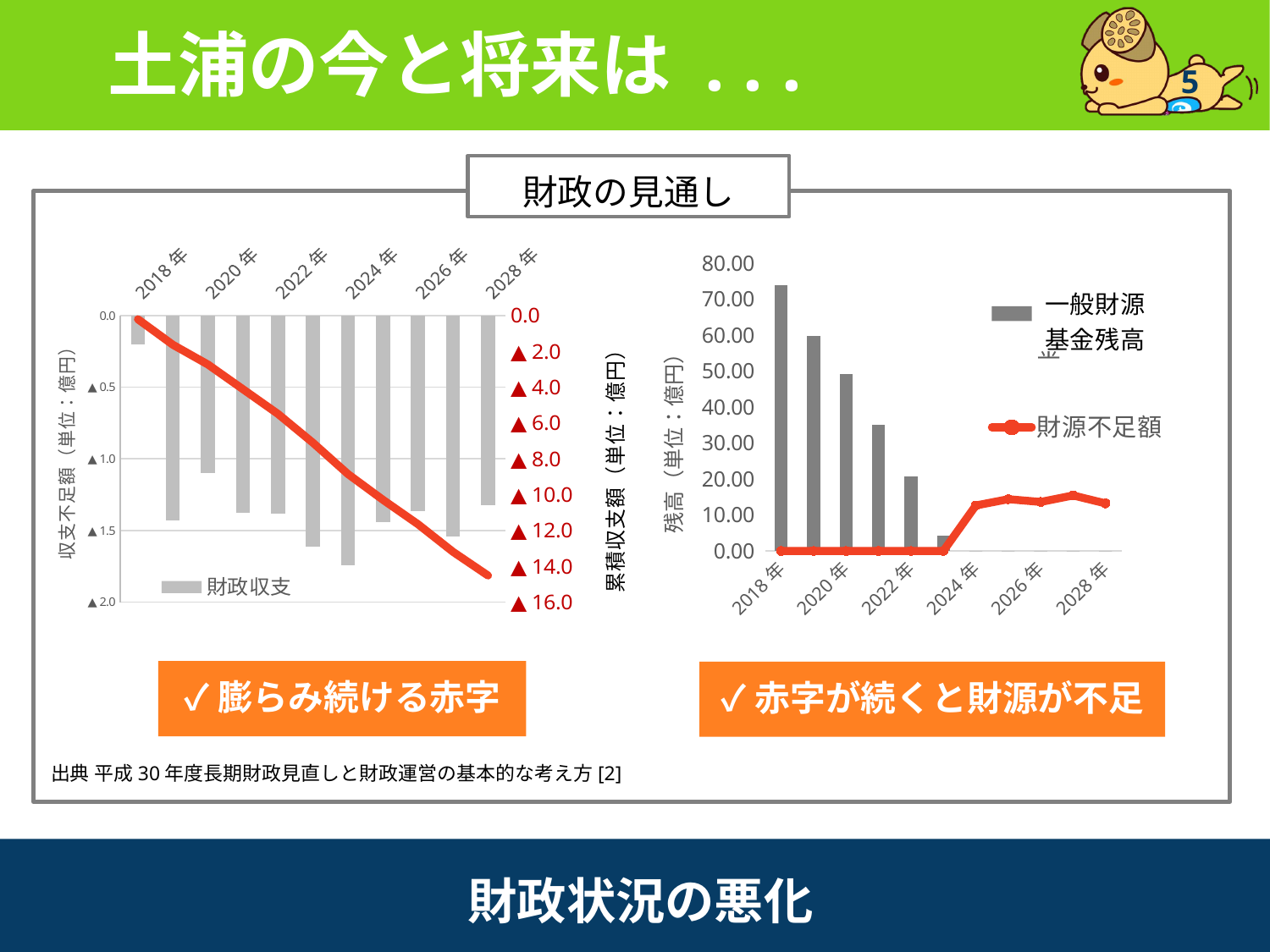
How many series does the legend of the right-hand chart list? 2 How many bars are plotted in the left-hand chart (財政収支)? 11 In the right-hand chart, do the 一般財源基金残高 bars rise or fall from 2018年 to 2023年? fall What kind of chart is the right-hand chart (残高)? Combined bar and line chart In the right-hand chart, which year has the highest 一般財源基金残高 bar? 2018年 In the right-hand chart, is the 一般財源基金残高 bar for 2018年 greater or less than 70.00? greater In the left-hand chart, does the red cumulative line rise or fall from 2018年 to 2028年? fall In the right-hand chart, which is larger: the 一般財源基金残高 bar for 2018年 or for 2022年? 2018年 In the right-hand chart, what is the 財源不足額 value for 2018年? 0.00 In the right-hand chart, is the 財源不足額 value for 2026年 greater or less than 10.00? greater What is the title shown above the two charts? 財政の見通し In the right-hand chart, is the 一般財源基金残高 bar for 2021年 greater or less than 40.00? less